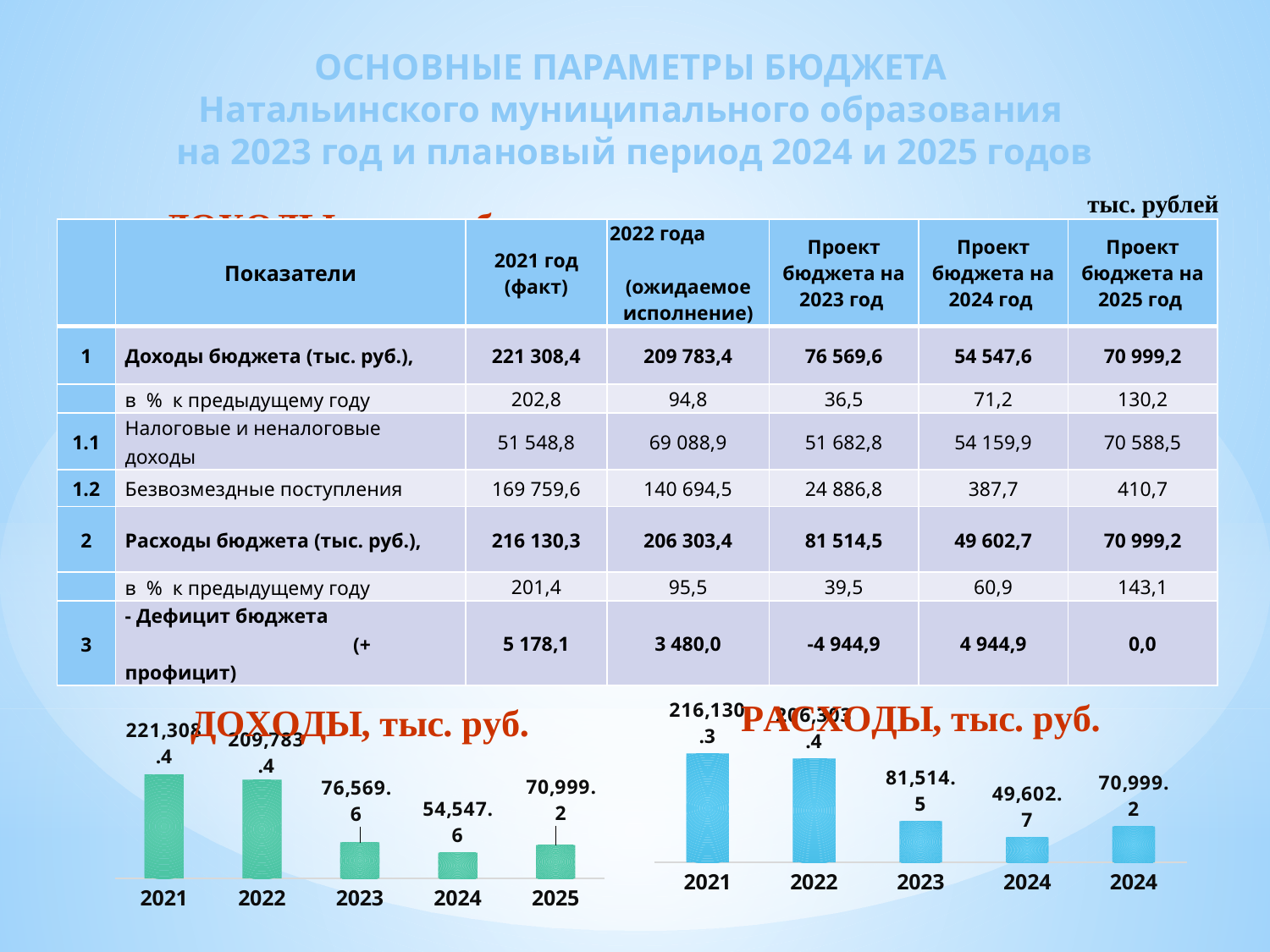
In the "ДОХОДЫ, тыс. руб." chart, which is larger, the value for 2024 or the value for 2025? 2025 How many bars are shown in the "ДОХОДЫ, тыс. руб." chart? 5 What kind of chart is the "ДОХОДЫ, тыс. руб." chart on the left? bar chart In the "ДОХОДЫ, тыс. руб." chart, what is the value for 2023? 76,569.6 In the "ДОХОДЫ, тыс. руб." chart, which year has the highest value? 2021 In the "ДОХОДЫ, тыс. руб." chart, what is the difference between the values for 2025 and 2024? 16,451.6 In the "РАСХОДЫ, тыс. руб." chart, what is the value of the lowest bar? 49,602.7 In the "ДОХОДЫ, тыс. руб." chart, which year has the lowest value? 2024 In the "РАСХОДЫ, тыс. руб." chart, what is the difference between the values for 2021 and 2023? 134,615.8 In the "ДОХОДЫ, тыс. руб." chart, what is the value for 2025? 70,999.2 In the "ДОХОДЫ, тыс. руб." chart, do the values rise or fall from 2021 to 2024? fall In the "РАСХОДЫ, тыс. руб." chart on the right, what is the value for 2023? 81,514.5